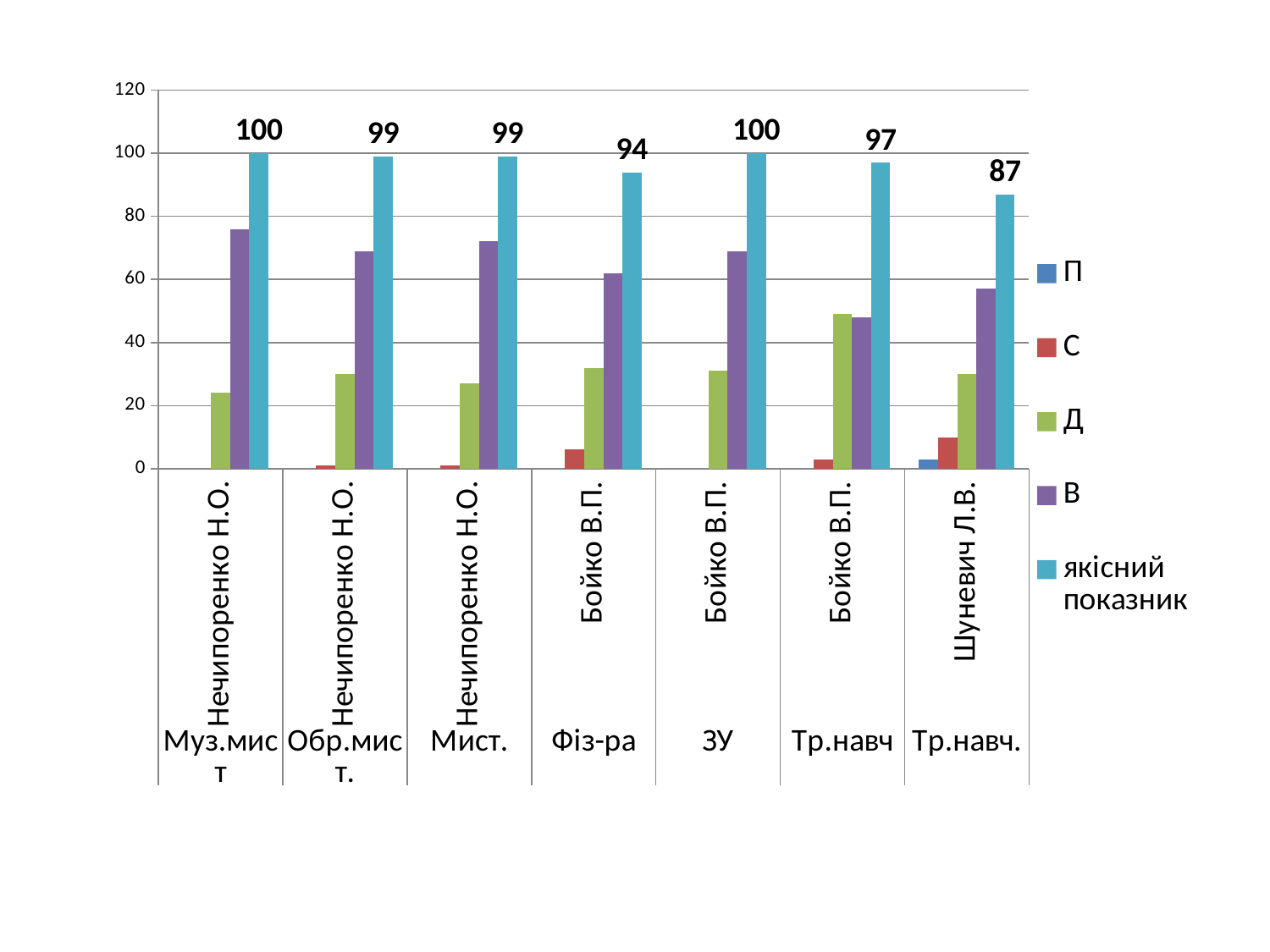
What kind of chart is shown on the slide? bar chart Is the value of series Д for Тр.навч (Бойко В.П.) greater or less than 40? greater Is the value of series В for Муз.мист (Нечипоренко Н.О.) greater or less than 60? greater What is the difference between the якісний показник for Муз.мист (Нечипоренко Н.О.) and for Тр.навч. (Шуневич Л.В.)? 13 How many series does the legend list? 5 What is the value of якісний показник for Тр.навч. (Шуневич Л.В.)? 87 How many categories are shown on the x axis? 7 Which has a higher якісний показник: Фіз-ра (Бойко В.П.) or Тр.навч (Бойко В.П.)? Тр.навч (Бойко В.П.) What is the difference between the якісний показник for Обр.мист. (Нечипоренко Н.О.) and for Фіз-ра (Бойко В.П.)? 5 What is the value of якісний показник for ЗУ (Бойко В.П.)? 100 Which category has the lowest якісний показник? Тр.навч. (Шуневич Л.В.) What is the value of якісний показник for Фіз-ра (Бойко В.П.)? 94